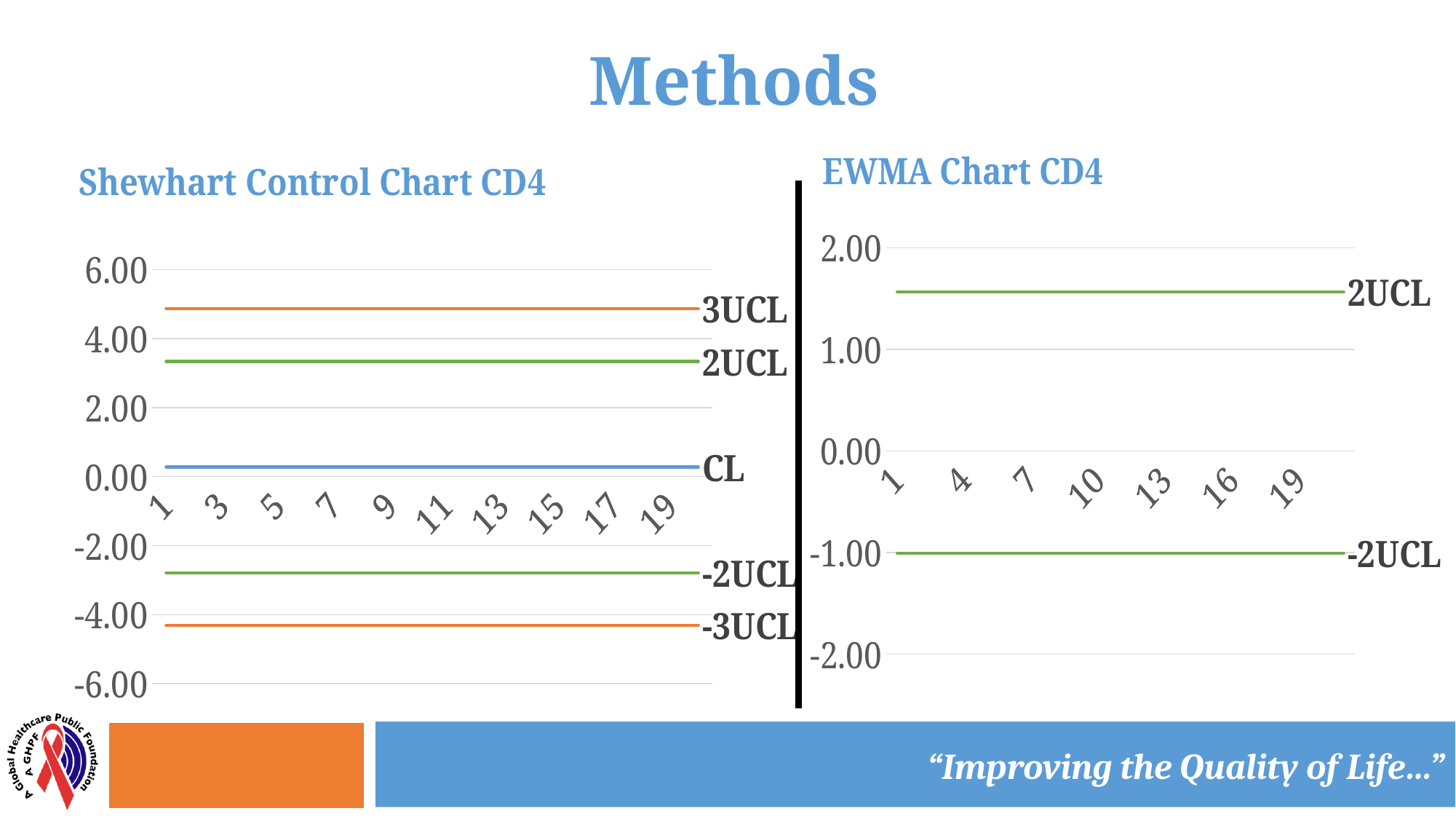
How many labelled lines are plotted in the Shewhart Control Chart CD4? 5 What kind of chart is the EWMA Chart CD4? line chart In the Shewhart Control Chart CD4, is the value of the -3UCL line greater or less than -4.00? less How many labelled lines are plotted in the EWMA Chart CD4? 2 In the EWMA Chart CD4, does the 2UCL line rise, fall, or stay flat along the x axis? stays flat In the Shewhart Control Chart CD4, is the value of the 2UCL line greater or less than 4.00? less What kind of chart is the Shewhart Control Chart CD4? line chart In the Shewhart Control Chart CD4, is the value of the 3UCL line greater or less than 4.00? greater In the Shewhart Control Chart CD4, which line is higher, 3UCL or 2UCL? 3UCL